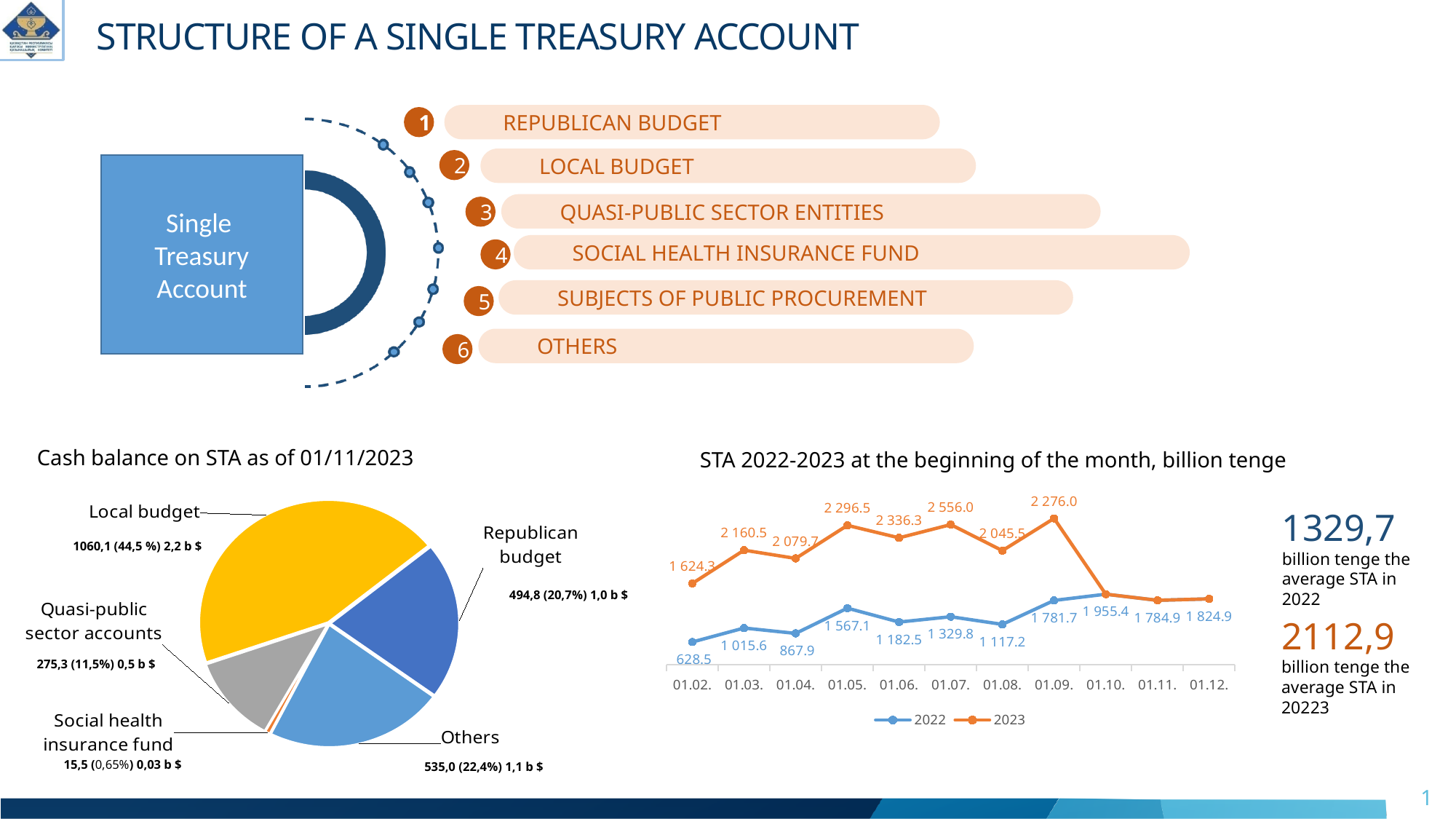
In the pie chart 'Cash balance on STA as of 01/11/2023', what value is shown for Others? 535,0 What type of chart is 'STA 2022-2023 at the beginning of the month, billion tenge'? Line chart In the pie chart 'Cash balance on STA as of 01/11/2023', how many categories are shown? 5 In the line chart 'STA 2022-2023 at the beginning of the month, billion tenge', how many series does the legend list? 2 In the pie chart 'Cash balance on STA as of 01/11/2023', what is the share of the Local budget slice? 44,5 % In the pie chart 'Cash balance on STA as of 01/11/2023', what is the percentage share of the Republican budget? 20,7% In the pie chart 'Cash balance on STA as of 01/11/2023', which category has the smallest slice? Social health insurance fund In the line chart 'STA 2022-2023 at the beginning of the month, billion tenge', what is the difference between the 2023 and 2022 values for 01.05.? 729.4 In the line chart 'STA 2022-2023 at the beginning of the month, billion tenge', what is the 2022 value for 01.02.? 628.5 In the line chart 'STA 2022-2023 at the beginning of the month, billion tenge', which month has the highest 2022 value? 01.10. In the pie chart 'Cash balance on STA as of 01/11/2023', which category has the largest slice? Local budget In the line chart 'STA 2022-2023 at the beginning of the month, billion tenge', what is the 2023 value for 01.07.? 2 556.0